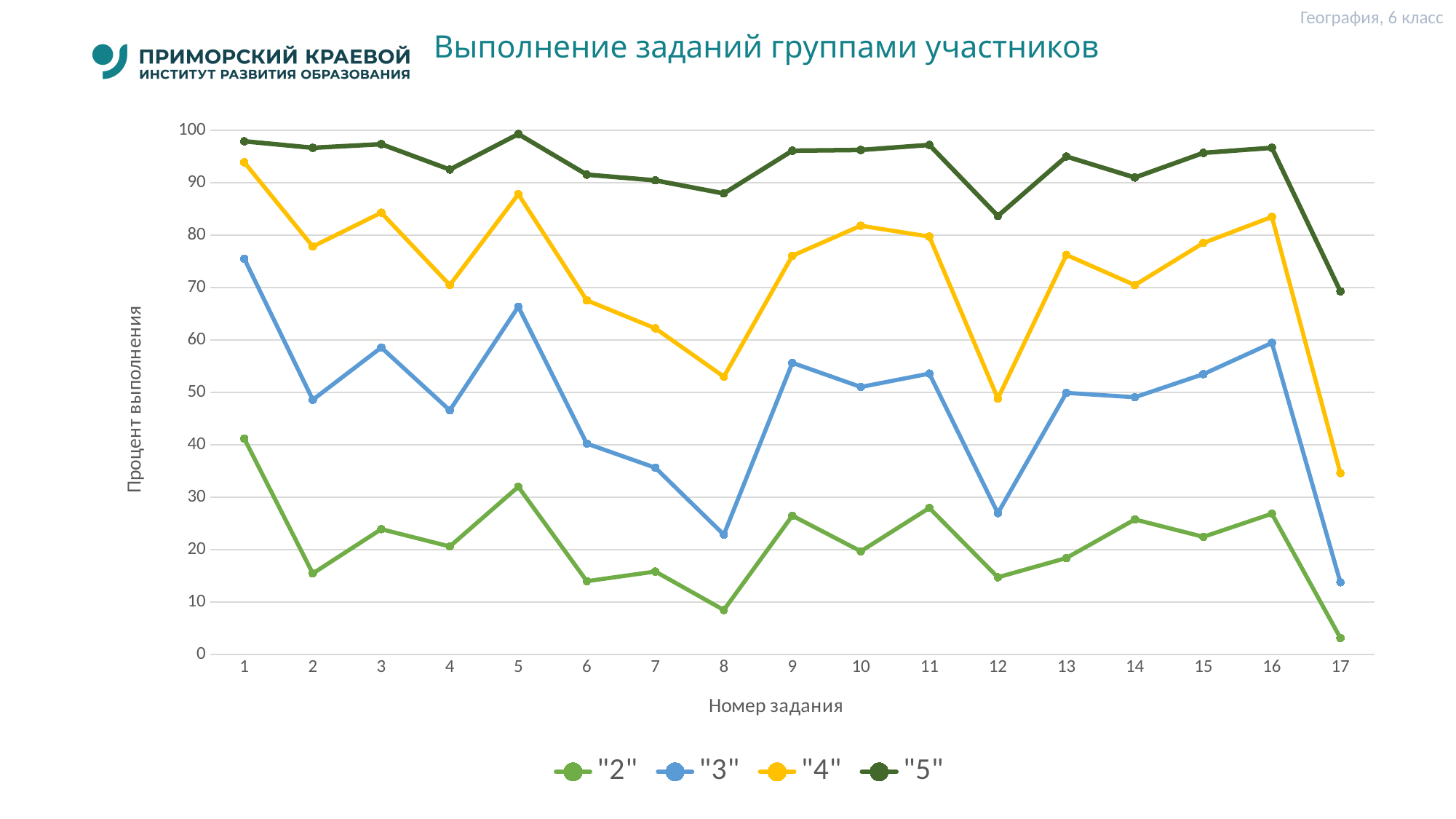
Is the value for series "3" at task 1 greater or less than 70? greater Is the value for series "4" at task 17 greater or less than 40? less Is the value for series "5" at task 17 greater or less than 80? less How many series does the legend list? 4 How many task numbers are plotted along the x axis? 17 Does the value for series "3" rise or fall from task 16 to task 17? fall What kind of chart is shown on the slide? line chart What is the title of the chart? Выполнение заданий группами участников For series "5", at which task number is the value lowest? 17 At task 8, which series has the larger value, "4" or "3"? "4" For series "2", at which task number is the value highest? 1